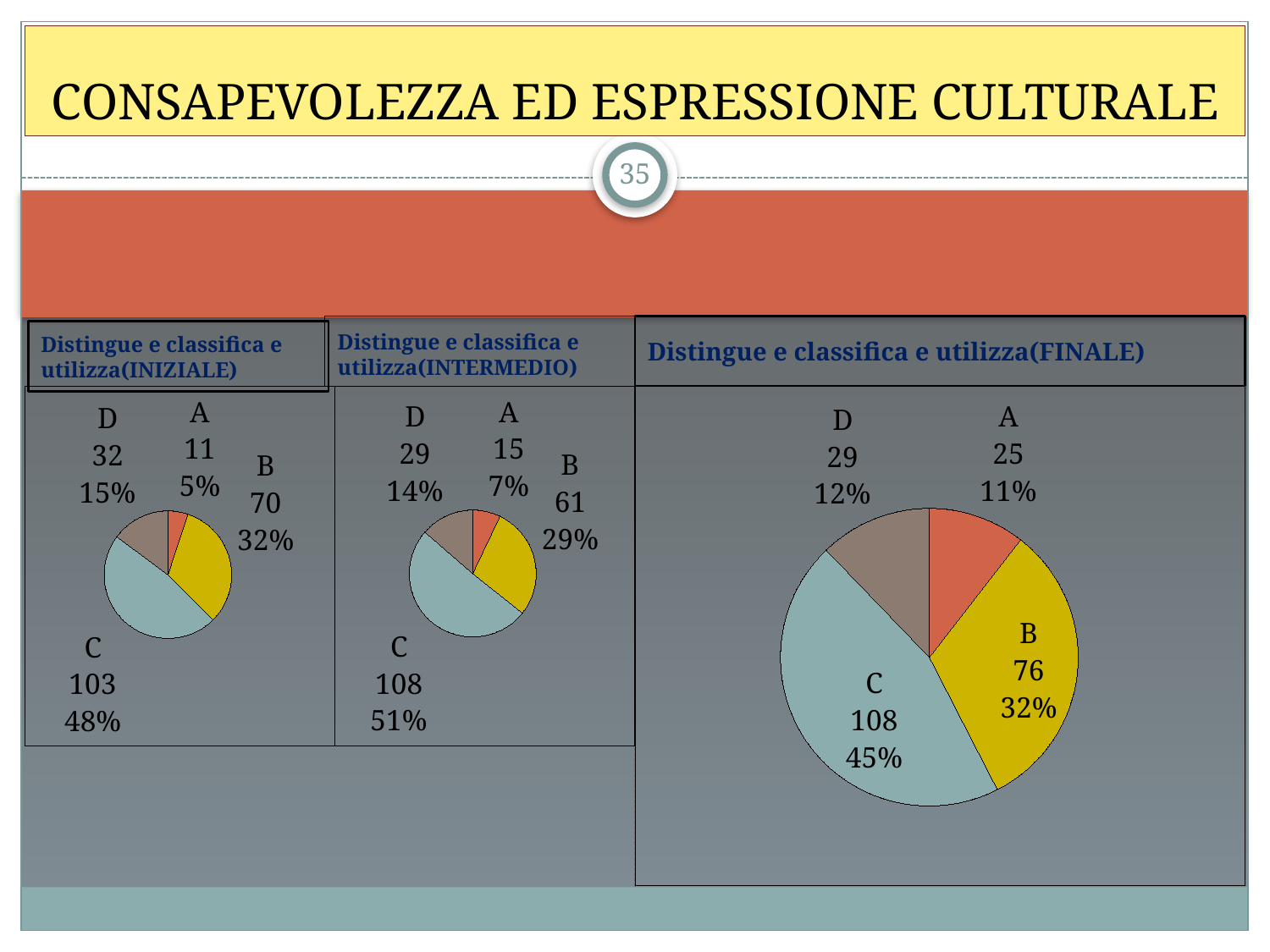
In the INIZIALE pie chart, which category has the smallest value? A In the FINALE pie chart, what is the value for category B? 76 How many categories does the INIZIALE pie chart show? 4 In the FINALE pie chart, what percentage share does category A have? 11% What kind of chart is used in the FINALE panel? Pie chart In the FINALE pie chart, what is the difference between the values for C and B? 32 In the INTERMEDIO pie chart, what is the value for category D? 29 In the INIZIALE pie chart, what percentage share does category B have? 32% In the INIZIALE pie chart, what is the value for category C? 103 In the INTERMEDIO pie chart, what percentage share does category C have? 51% In the INTERMEDIO pie chart, which category has the largest value? C In the FINALE pie chart, which is larger, the value for D or the value for A? D